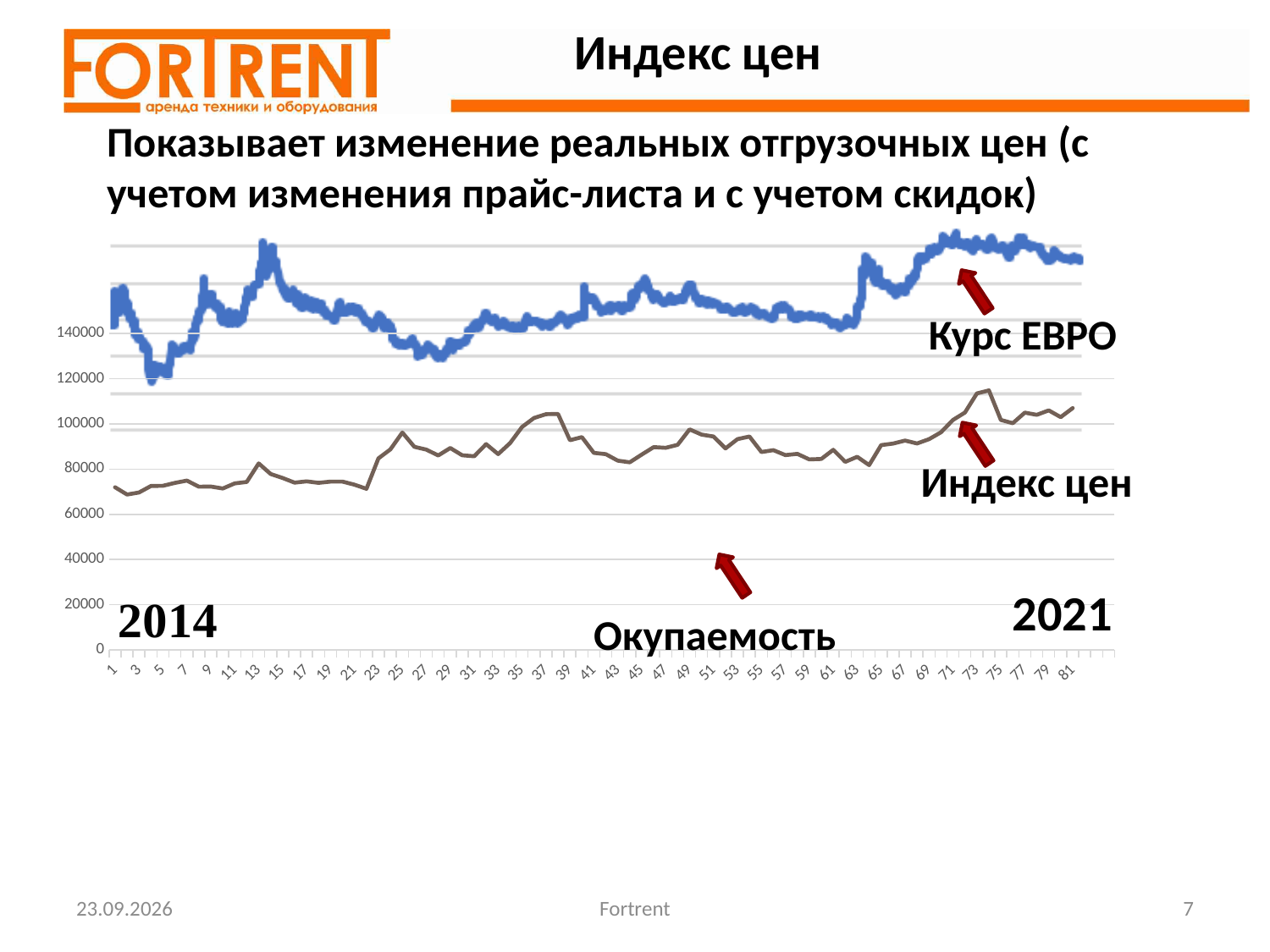
Is the value of the Индекс цен line at point 23 greater or less than 80000? greater Is the value of the Индекс цен line at point 37 greater or less than 100000? greater Which line on the chart is labelled "Курс ЕВРО", the blue one or the brown one? the blue one Which is larger on the Индекс цен line: the value at point 37 or the value at point 45? point 37 Is the value of the Индекс цен line at point 1 greater or less than 60000? greater Does the Индекс цен line overall rise or fall from 2014 to 2021? rise What is the title of the chart on the slide? Индекс цен What kind of chart is shown on the slide? line chart